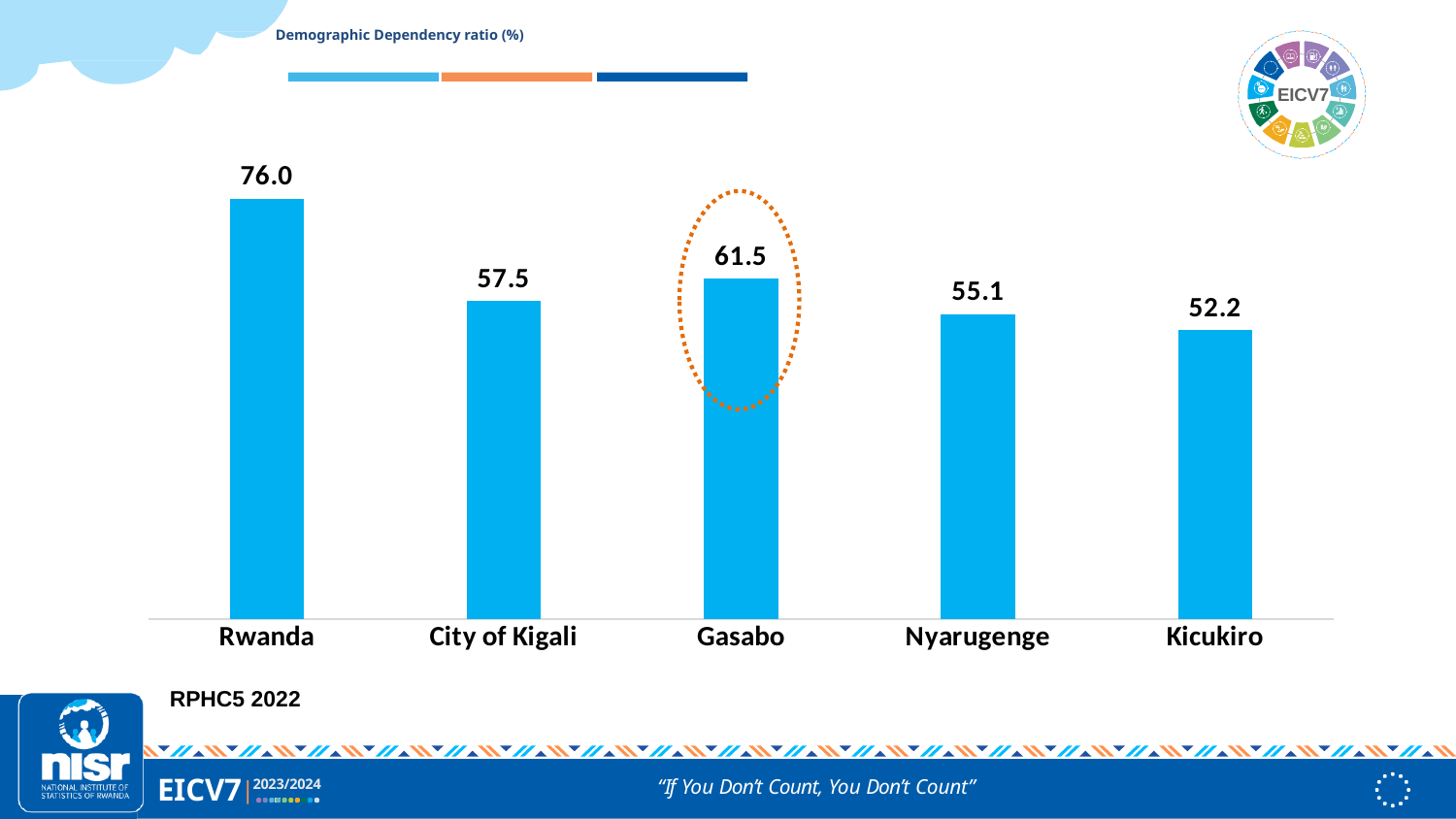
What is the demographic dependency ratio for Rwanda? 76.0 What type of chart is shown on the slide? Bar chart What is the demographic dependency ratio for Nyarugenge? 55.1 What is the difference between the dependency ratio for Gasabo and Kicukiro? 9.3 What is the difference between the dependency ratio for Rwanda and City of Kigali? 18.5 Which has a higher dependency ratio, Gasabo or Nyarugenge? Gasabo Which category has the lowest demographic dependency ratio? Kicukiro What is the demographic dependency ratio for Kicukiro? 52.2 What is the demographic dependency ratio for Gasabo? 61.5 Which category has the highest demographic dependency ratio? Rwanda Which bar is highlighted with a dotted orange circle? Gasabo How many categories are shown in the chart? 5